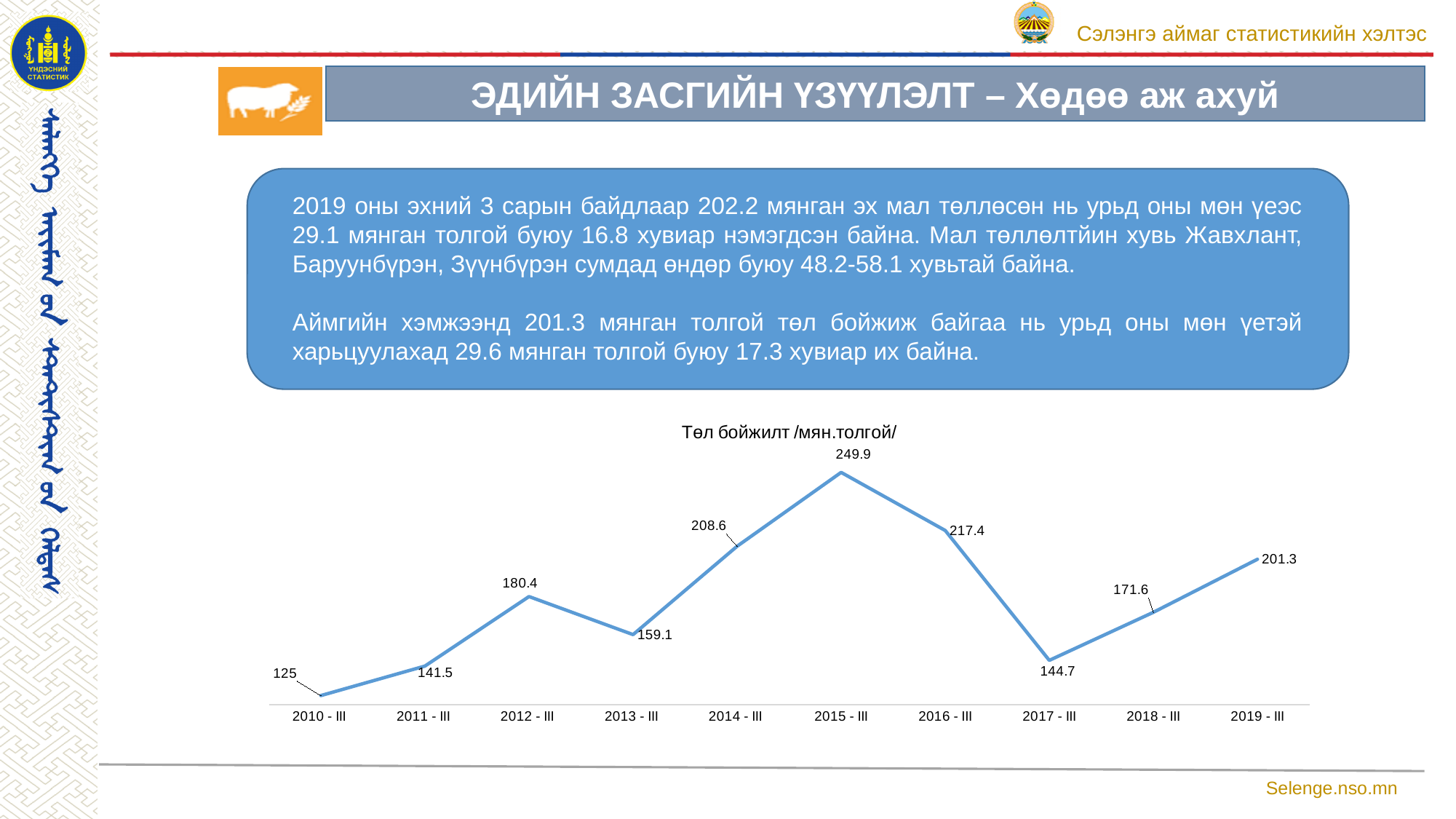
What is the title of the chart? Төл бойжилт /мян.толгой/ What is the value for 2019 - III? 201.3 What type of chart is shown on the slide? line chart Which period has the highest value? 2015 - III What is the value for 2013 - III? 159.1 What is the value for 2015 - III? 249.9 Do the values rise or fall from 2016 - III to 2017 - III? fall Which period has the lowest value? 2010 - III Which is larger, the value for 2014 - III or the value for 2016 - III? 2016 - III How many data points are plotted on the chart? 10 What is the difference between the values for 2019 - III and 2018 - III? 29.7 What is the difference between the values for 2015 - III and 2016 - III? 32.5